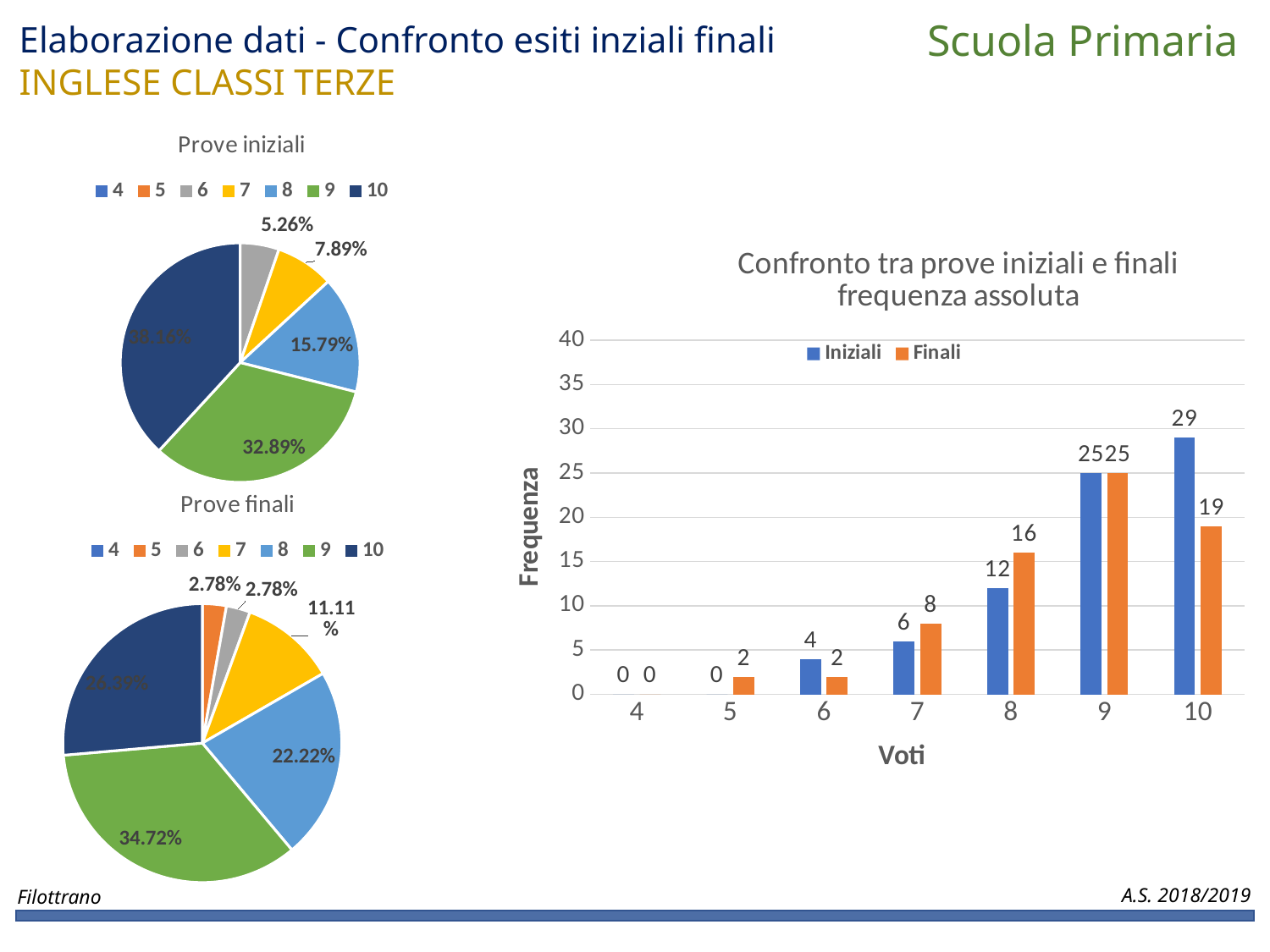
What kind of chart is 'Confronto tra prove iniziali e finali frequenza assoluta'? bar chart In the 'Confronto tra prove iniziali e finali frequenza assoluta' bar chart, what is the Iniziali value for voto 10? 29 In the 'Confronto tra prove iniziali e finali frequenza assoluta' bar chart, how many voti categories are shown on the x axis? 7 In the 'Confronto tra prove iniziali e finali frequenza assoluta' bar chart, is the Finali value for voto 7 larger or smaller than the Iniziali value for voto 7? larger In the 'Confronto tra prove iniziali e finali frequenza assoluta' bar chart, which voto has the highest Iniziali value? 10 In the 'Confronto tra prove iniziali e finali frequenza assoluta' bar chart, which voto has the highest Finali value? 9 In the 'Confronto tra prove iniziali e finali frequenza assoluta' bar chart, what is the difference between the Iniziali and Finali values for voto 10? 10 In the 'Confronto tra prove iniziali e finali frequenza assoluta' bar chart, what is the Finali value for voto 8? 16 In the 'Prove finali' pie chart, what share does voto 8 have? 22.22% In the 'Prove finali' pie chart, what share does voto 7 have? 11.11% In the 'Prove iniziali' pie chart, what share does voto 9 have? 32.89% In the 'Confronto tra prove iniziali e finali frequenza assoluta' bar chart, how many series does the legend list? 2